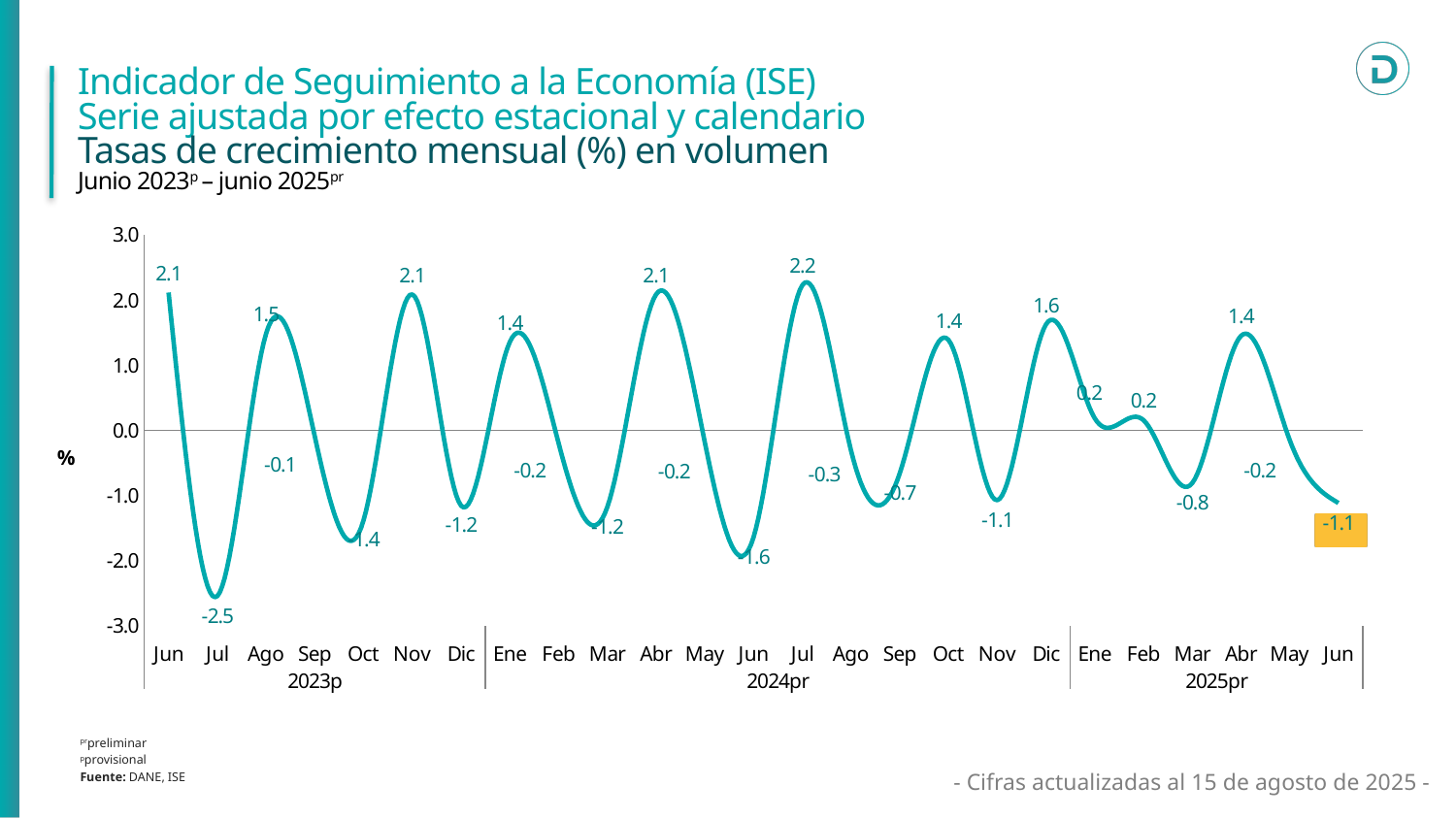
What is the monthly growth rate for Jul 2024pr? 2.2 What is the monthly growth rate for Jun 2025pr? -1.1 Which is larger, the value for Abr 2025pr or the value for Dic 2024pr? Dic 2024pr Which month has the lowest monthly growth rate? Jul 2023p What is the value for Dic 2024pr? 1.6 What is the difference between the values for Jul 2024pr and Jun 2024pr? 3.8 Which month has the highest monthly growth rate? Jul 2024pr What type of chart is shown on the slide? Line chart How many monthly data points are plotted on the chart? 25 What is the label on the vertical axis of the chart? % Does the value rise or fall from Abr 2025pr to Jun 2025pr? Fall What is the value for Jul 2023p? -2.5